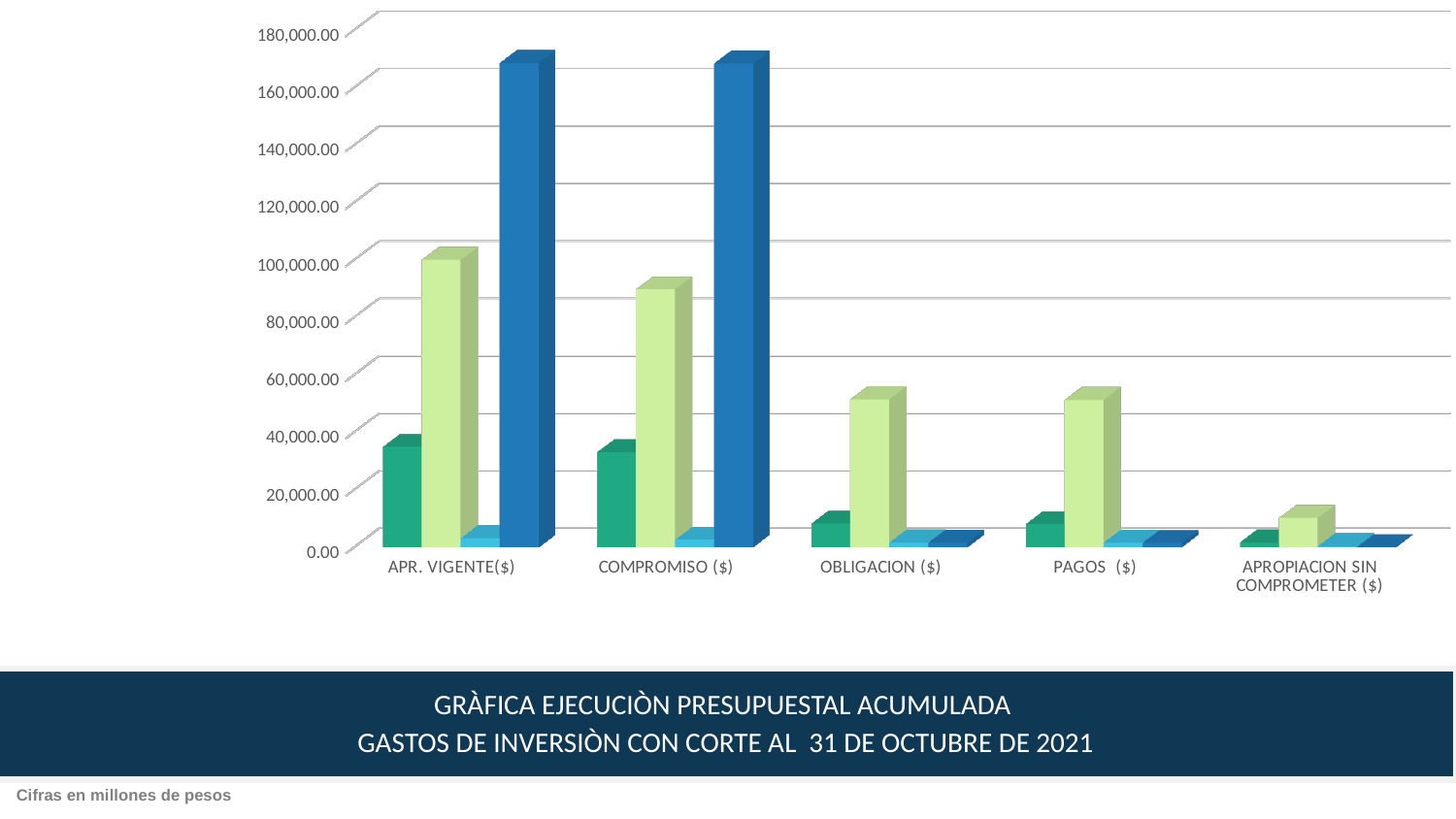
Is the dark blue bar for APR. VIGENTE($) greater or less than 160,000.00? greater Do the light green bars generally rise or fall from left to right across the categories? fall Is the light green bar for OBLIGACION ($) greater or less than 60,000.00? less Is the dark green bar for APR. VIGENTE($) greater or less than 20,000.00? greater What kind of chart is shown on the slide? bar chart Which category has the shortest light green bar? APROPIACION SIN COMPROMETER ($) Which category has the tallest light green bar? APR. VIGENTE($) How many categories are shown along the x axis of the chart? 5 Which is larger, the light green bar for APR. VIGENTE($) or the light green bar for COMPROMISO ($)? APR. VIGENTE($) What unit note is printed at the bottom of the slide? Cifras en millones de pesos